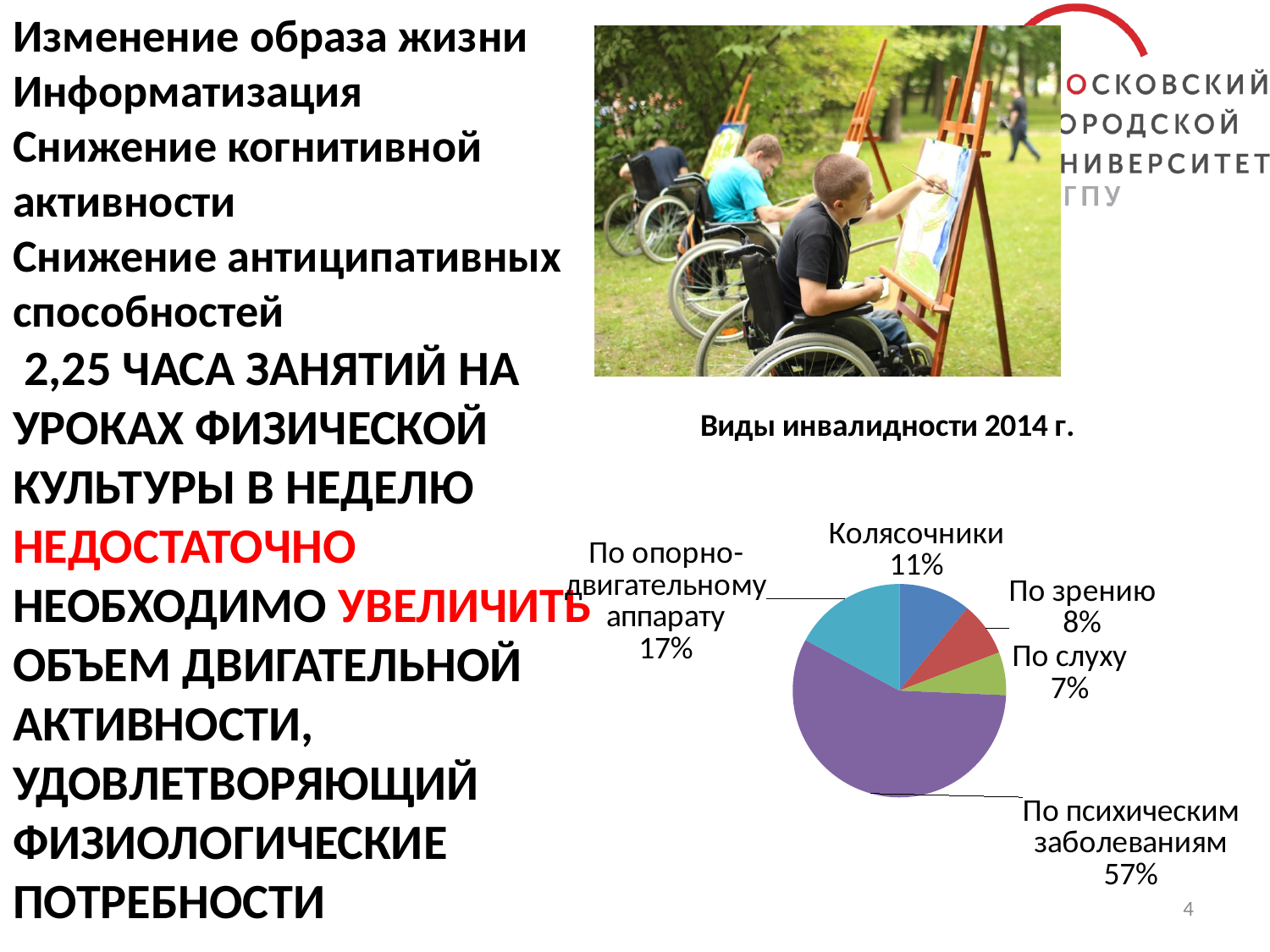
Which category has the smallest slice of the pie? По слуху What is the title of the chart? Виды инвалидности 2014 г. What is the difference in percentage points between "По психическим заболеваниям" and "По опорно-двигательному аппарату"? 40 What share of the pie is labelled "По слуху"? 7% What colour is the slice for "По психическим заболеваниям"? purple How many slices does the pie chart have? 5 What share of the pie is labelled "По психическим заболеваниям"? 57% What share of the pie is labelled "Колясочники"? 11% Which category has the largest slice of the pie? По психическим заболеваниям What kind of chart is shown on the slide? pie chart What share of the pie is labelled "По опорно-двигательному аппарату"? 17% Which is larger, the share for "Колясочники" or the share for "По зрению"? Колясочники